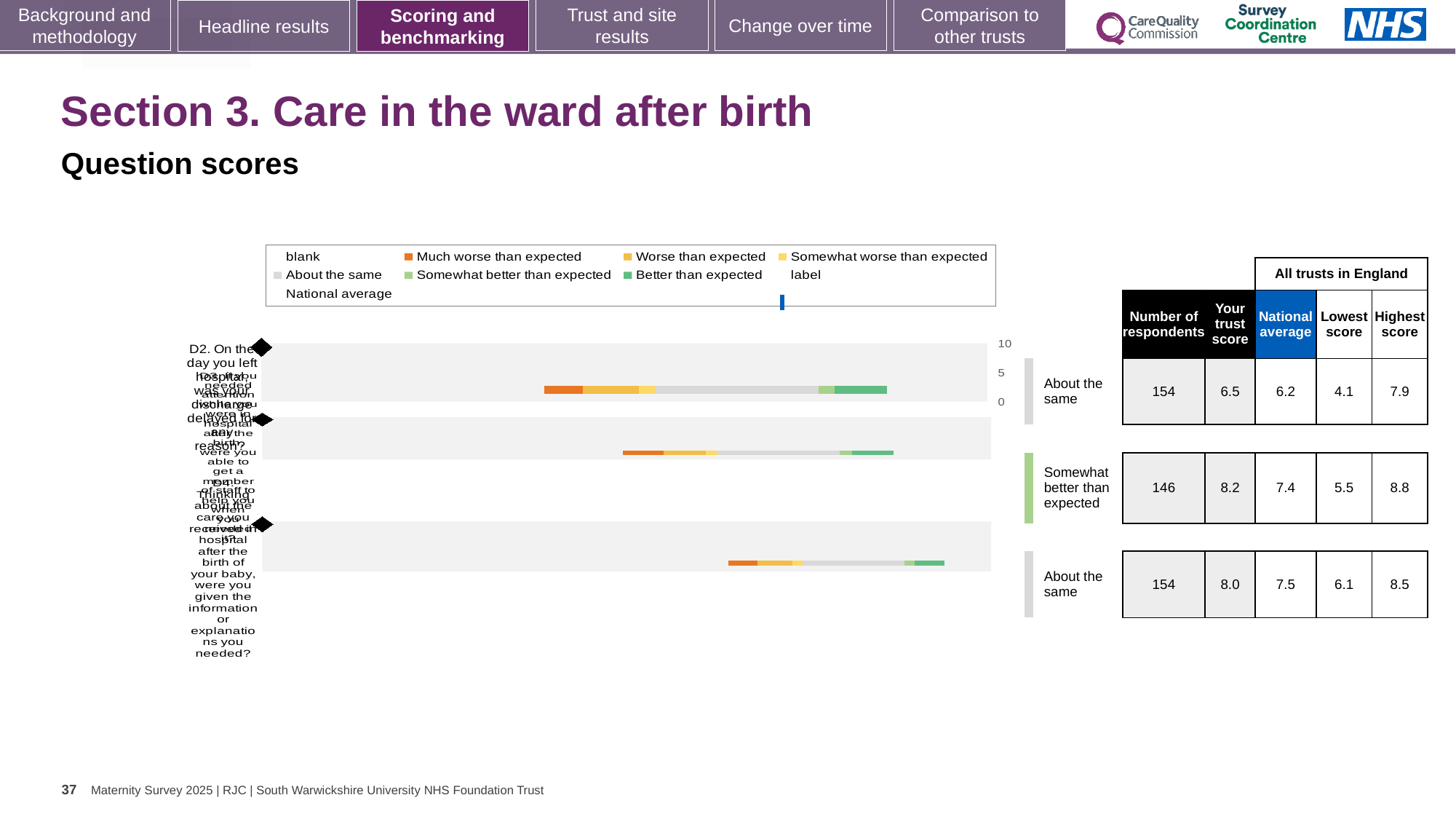
In the table beside the chart, for the middle row, which is larger: 'Your trust score' or the national average? Your trust score What colour does the legend use for 'Much worse than expected'? orange In the table beside the chart, what is the national average for the top row? 6.2 What colour does the legend use for 'Better than expected'? green In the table beside the chart, what is the number of respondents for the middle row (Somewhat better than expected)? 146 How many bars are plotted in the chart? 3 In the table beside the chart, what is the highest score for the bottom row? 8.5 In the table beside the chart, what is the lowest score for the middle row? 5.5 In the table beside the chart, what is 'Your trust score' for the top row? 6.5 In the table beside the chart, which row has the highest 'Your trust score'? the middle row (Somewhat better than expected) In the table beside the chart, what is the difference between the highest score and the lowest score for the bottom row? 2.4 What kind of chart is shown on the slide? bar chart